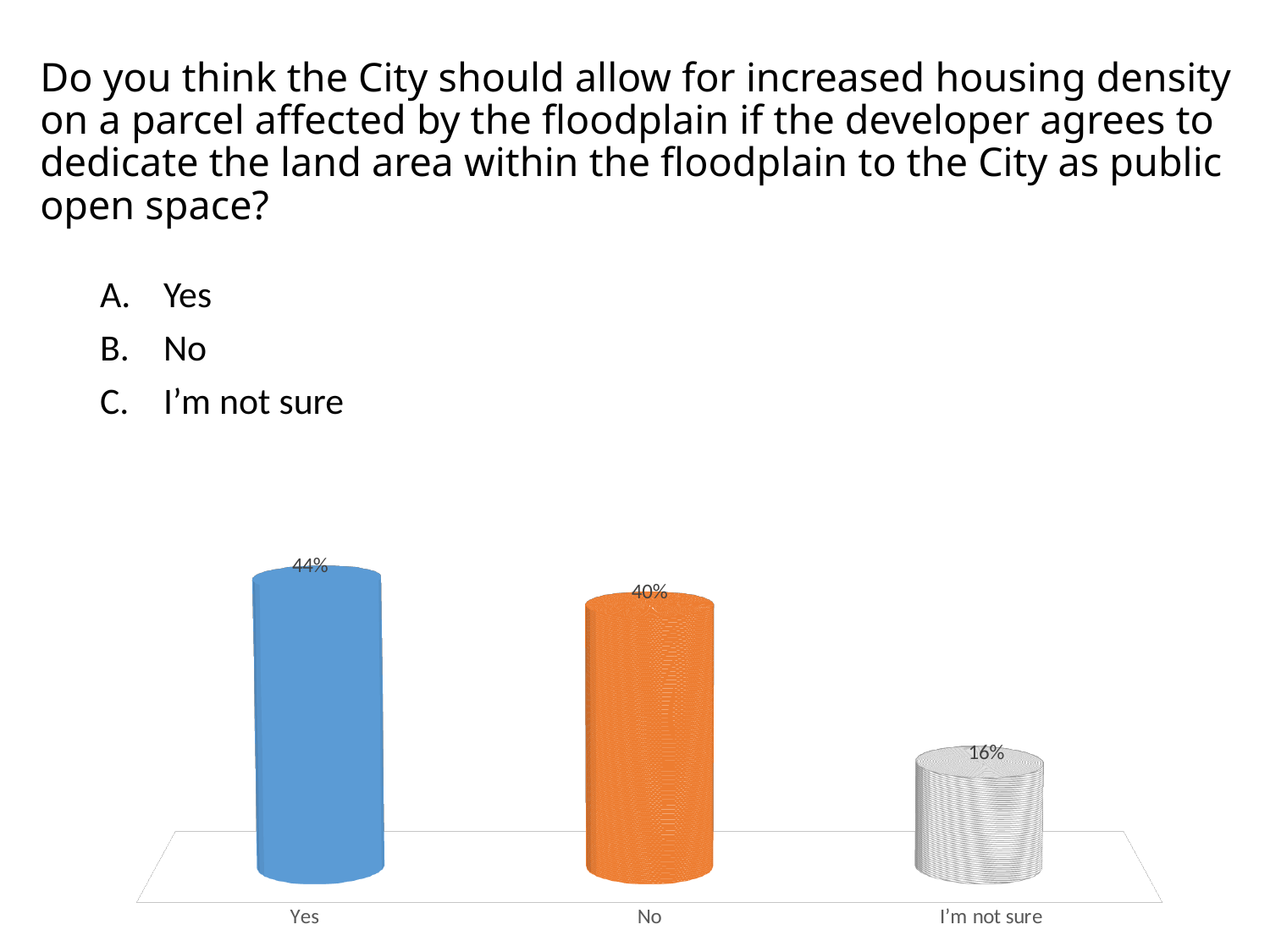
Which response received the highest percentage? Yes Do the values rise or fall moving from left to right across the categories? Fall What percentage of respondents answered "I'm not sure"? 16% What percentage of respondents answered "No"? 40% What is the difference in percentage points between "Yes" and "No"? 4 What colour is the bar for "No"? Orange What percentage of respondents answered "Yes"? 44% What kind of chart is shown on the slide? Bar chart How many response categories are shown in the chart? 3 What is the difference in percentage points between "No" and "I'm not sure"? 24 Which received a larger share of responses, "No" or "I'm not sure"? No Which response received the lowest percentage? I'm not sure